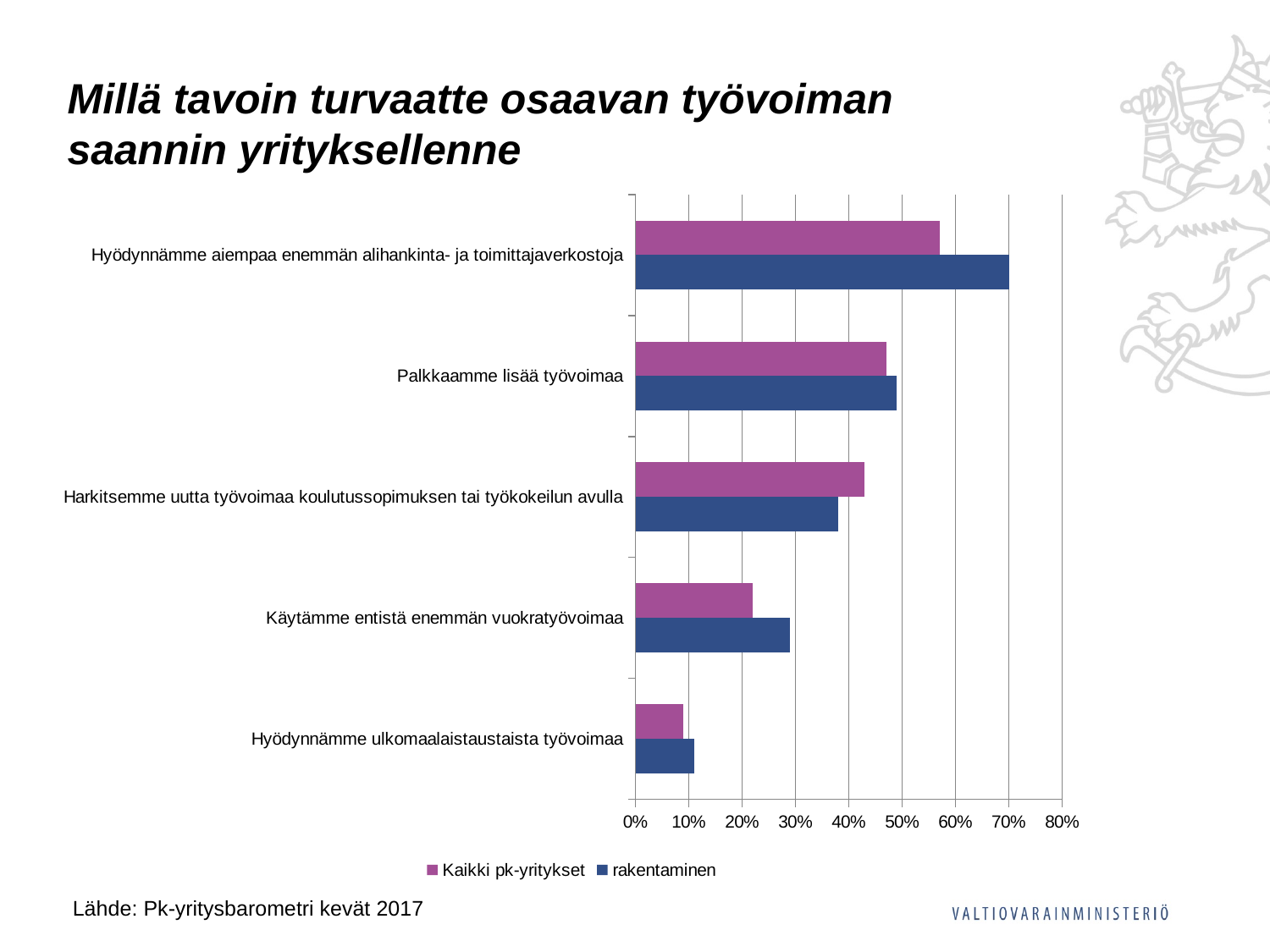
Which category has the highest value for the rakentaminen series? Hyödynnämme aiempaa enemmän alihankinta- ja toimittajaverkostoja How many categories (response options) are shown in the chart? 5 For 'Harkitsemme uutta työvoimaa koulutussopimuksen tai työkokeilun avulla', which series has the larger value, Kaikki pk-yritykset or rakentaminen? Kaikki pk-yritykset Is the Kaikki pk-yritykset value for 'Hyödynnämme aiempaa enemmän alihankinta- ja toimittajaverkostoja' greater or less than 50%? greater How many series does the legend list? 2 What are the two series named in the legend? Kaikki pk-yritykset and rakentaminen Which category has the lowest value for the Kaikki pk-yritykset series? Hyödynnämme ulkomaalaistaustaista työvoimaa Is the rakentaminen value for 'Käytämme entistä enemmän vuokratyövoimaa' greater or less than 20%? greater What is the rakentaminen value for 'Hyödynnämme aiempaa enemmän alihankinta- ja toimittajaverkostoja'? 70% For 'Käytämme entistä enemmän vuokratyövoimaa', which series has the larger value, Kaikki pk-yritykset or rakentaminen? rakentaminen What kind of chart is shown on the slide? bar chart